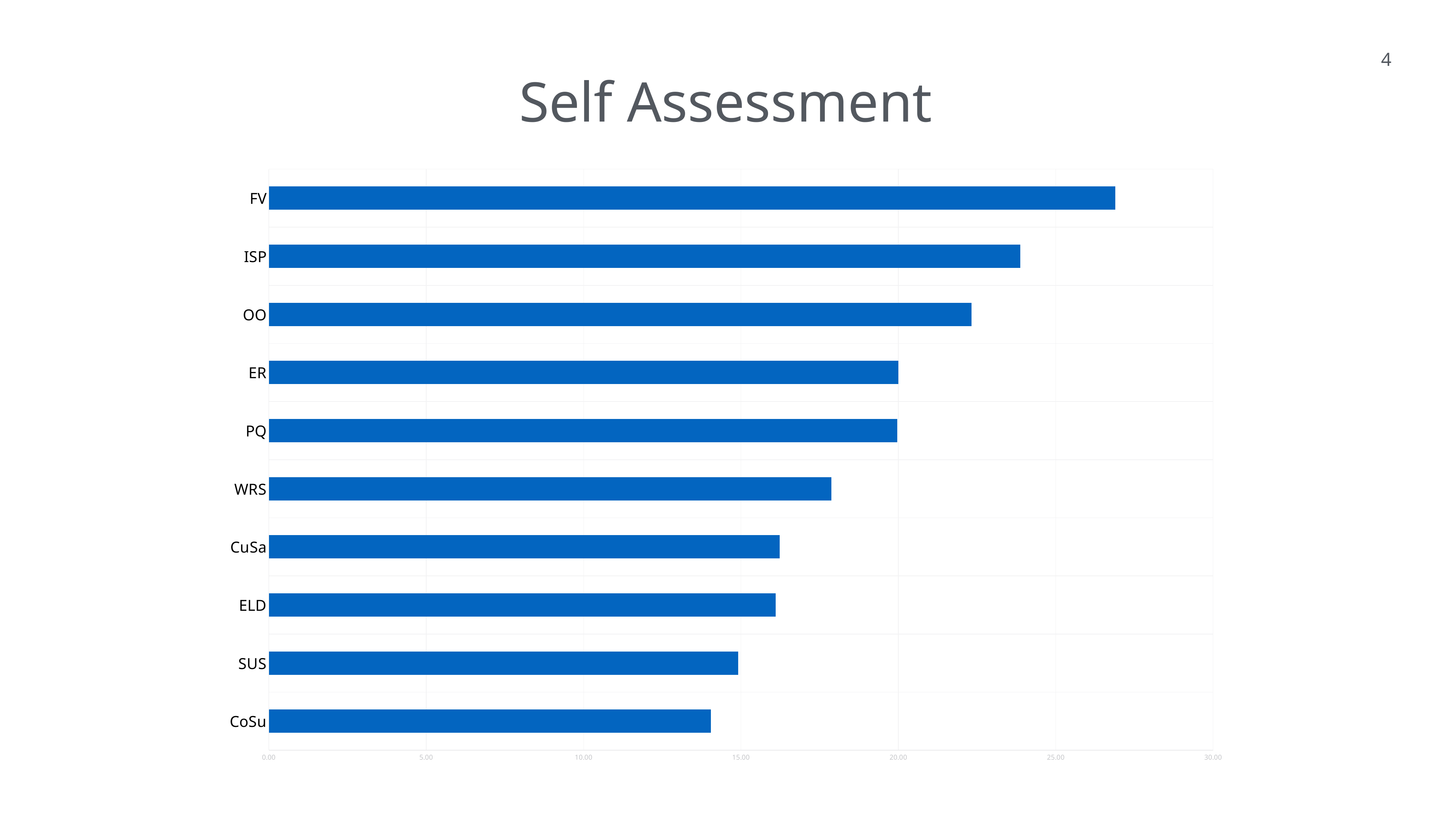
Which has the larger value, CuSa or WRS? WRS Which has the larger value, ISP or OO? ISP Is the value for CoSu greater or less than 15.00? less What colour are the bars in the chart? blue Is the value for OO greater or less than 20.00? greater Which category has the lowest value? CoSu Is the value for WRS greater or less than 20.00? less How many categories are plotted in the chart? 10 What is the title of the slide? Self Assessment What kind of chart is shown on the slide? bar chart Which category has the highest value? FV